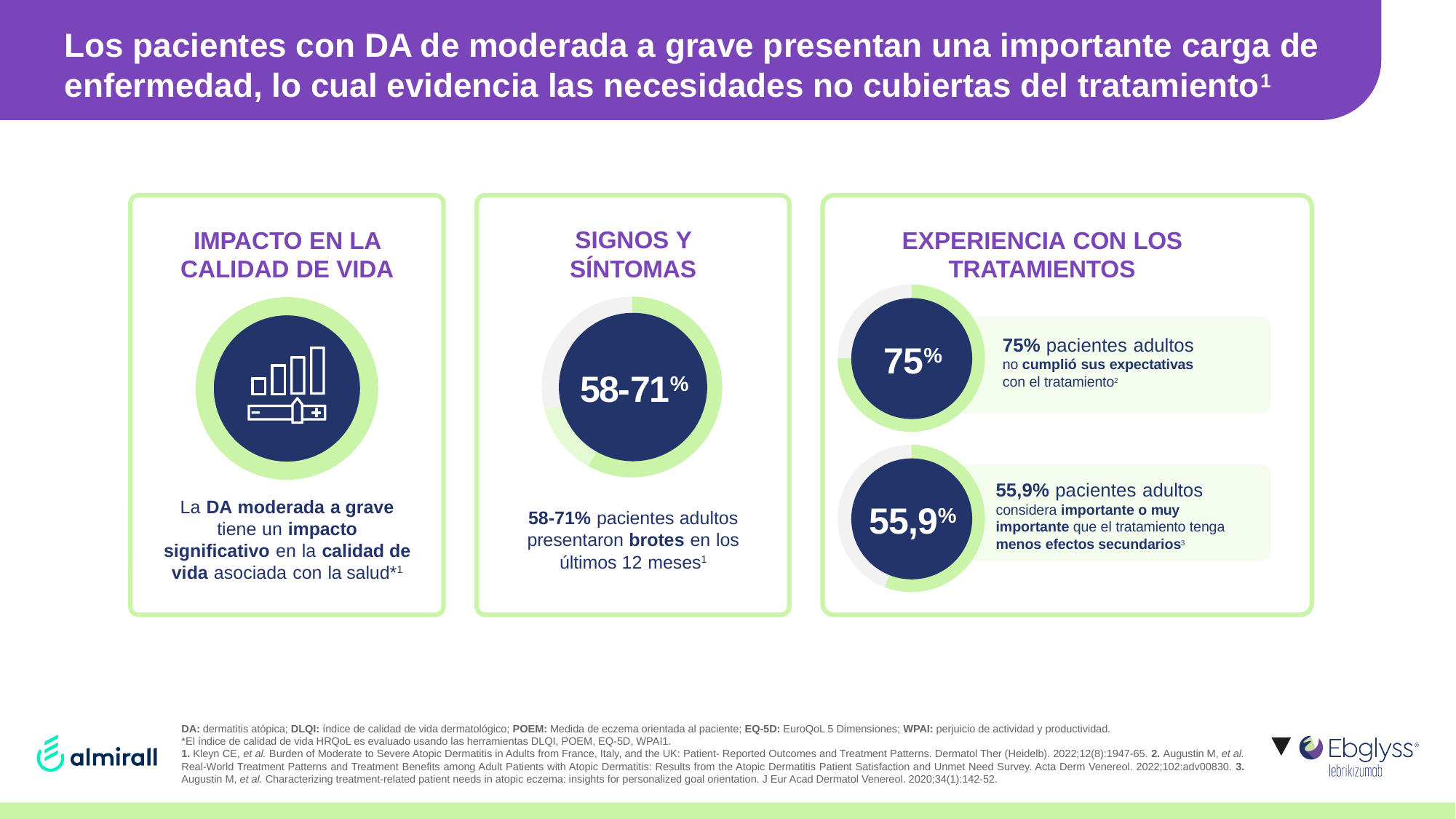
In the 'EXPERIENCIA CON LOS TRATAMIENTOS' panel, what is the difference between the upper ring value and the lower ring value? 19,1% What colour is the filled portion of the ring around the 55,9% chart? light green In the 'EXPERIENCIA CON LOS TRATAMIENTOS' panel, what percentage of adult patients did not meet their expectations with treatment? 75% In the 'EXPERIENCIA CON LOS TRATAMIENTOS' panel, what is the highest value shown in the ring charts? 75% In the 'SIGNOS Y SÍNTOMAS' ring chart, what percentage is shown in the centre? 58-71% In the 'EXPERIENCIA CON LOS TRATAMIENTOS' panel, which ring chart shows the larger value, the upper one or the lower one? the upper one (75%) What kind of chart is used to display the 75% value? doughnut (ring) chart In the 'EXPERIENCIA CON LOS TRATAMIENTOS' panel, what value is shown in the upper ring chart? 75% Which panel title appears above the ring chart showing 58-71%? SIGNOS Y SÍNTOMAS How many ring (doughnut) charts with a percentage value are shown on the slide in total? 3 How many ring charts are shown in the 'EXPERIENCIA CON LOS TRATAMIENTOS' panel? 2 In the 'EXPERIENCIA CON LOS TRATAMIENTOS' panel, what value is shown in the lower ring chart? 55,9%